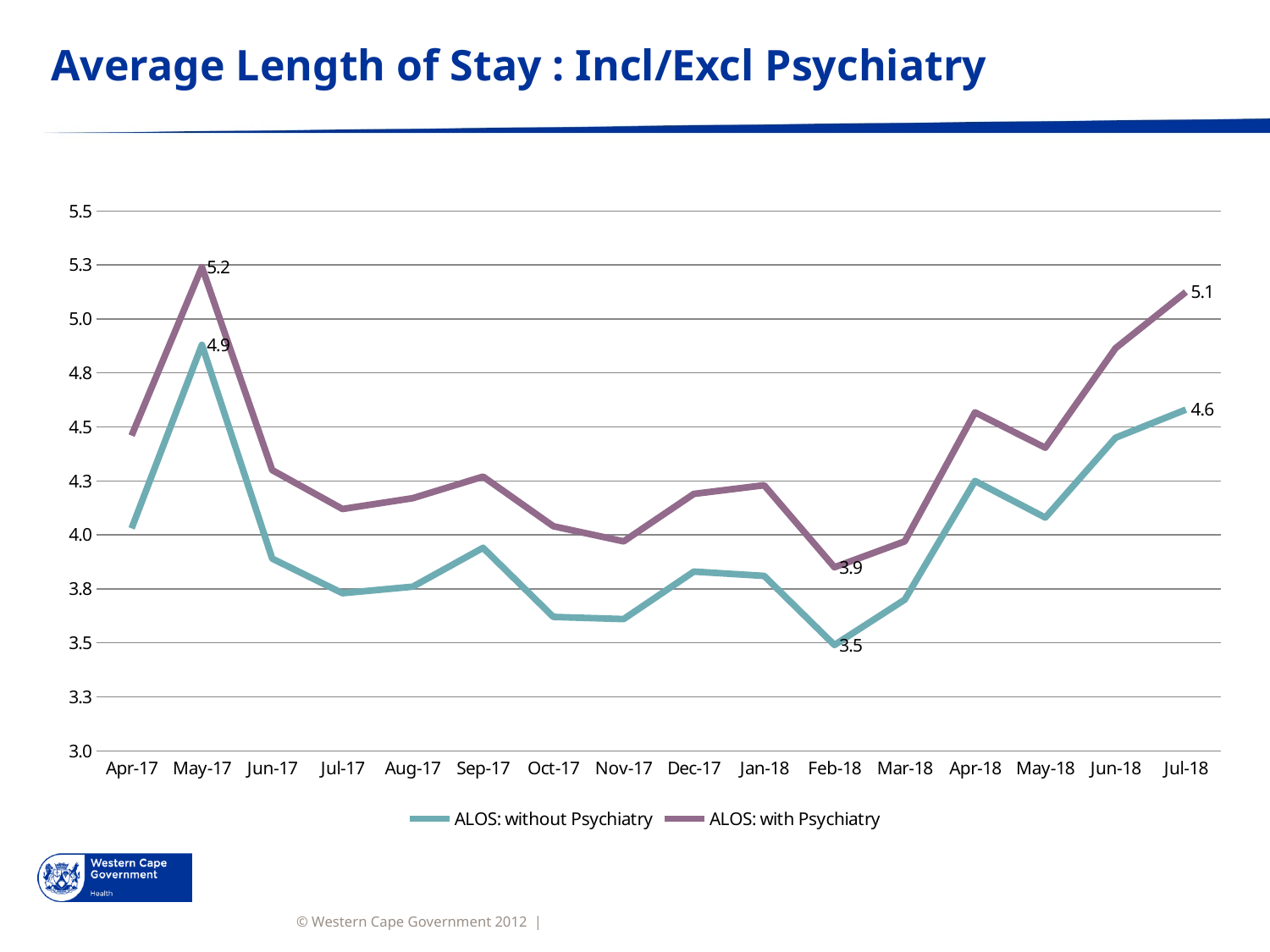
Which series has the higher value in May-17, ALOS: with Psychiatry or ALOS: without Psychiatry? ALOS: with Psychiatry What is the value for ALOS: with Psychiatry in Jul-18? 5.1 What kind of chart is shown on the slide? line chart Is the value for ALOS: without Psychiatry in Oct-17 greater or less than 3.8? less In which month is ALOS: without Psychiatry at its lowest? Feb-18 Does ALOS: without Psychiatry rise or fall from Feb-18 to Jul-18? rise How many months are shown on the x axis? 16 In which month does ALOS: with Psychiatry reach its highest value? May-17 What is the value for ALOS: with Psychiatry in May-17? 5.2 What is the difference between ALOS: with Psychiatry and ALOS: without Psychiatry in Jul-18? 0.5 What is the value for ALOS: without Psychiatry in Feb-18? 3.5 How many series does the legend list? 2